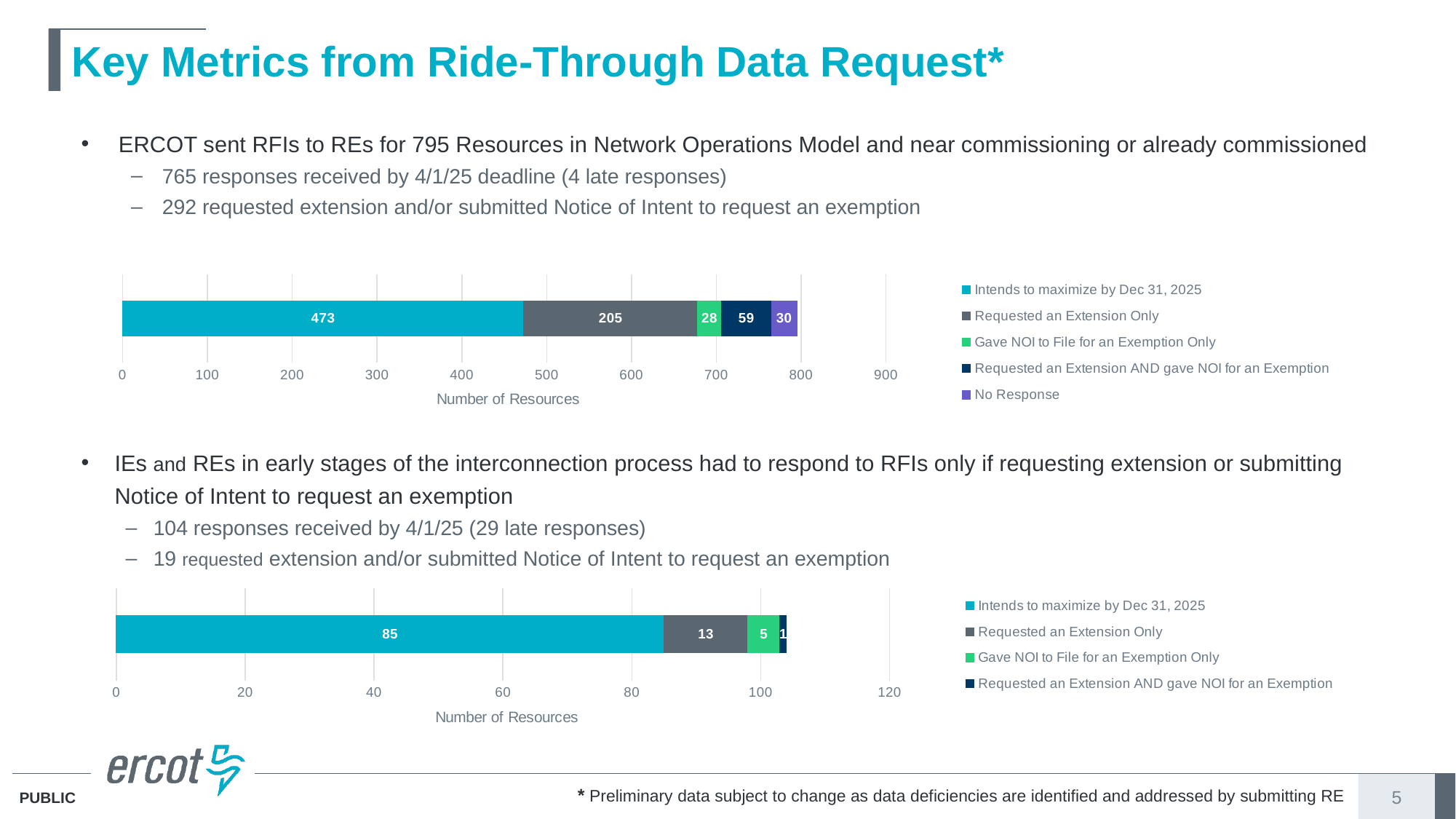
In the top chart, what is the value for 'Requested an Extension Only'? 205 What type of chart is the bottom chart? Stacked bar chart In the top chart, what is the total of the stacked bar? 795 In the bottom chart, what is the value for 'Requested an Extension Only'? 13 How many series does the legend of the top chart list? 5 In the bottom chart, what is the total of the stacked bar? 104 In the top chart, which series has the smallest segment? Gave NOI to File for an Exemption Only In the top chart, how many resources intend to maximize by Dec 31, 2025? 473 In the bottom chart, what is the value for 'Gave NOI to File for an Exemption Only'? 5 How many series does the legend of the bottom chart list? 4 In the top chart, what is the difference between 'Intends to maximize by Dec 31, 2025' and 'Requested an Extension Only'? 268 In the top chart, what is the value for 'No Response'? 30